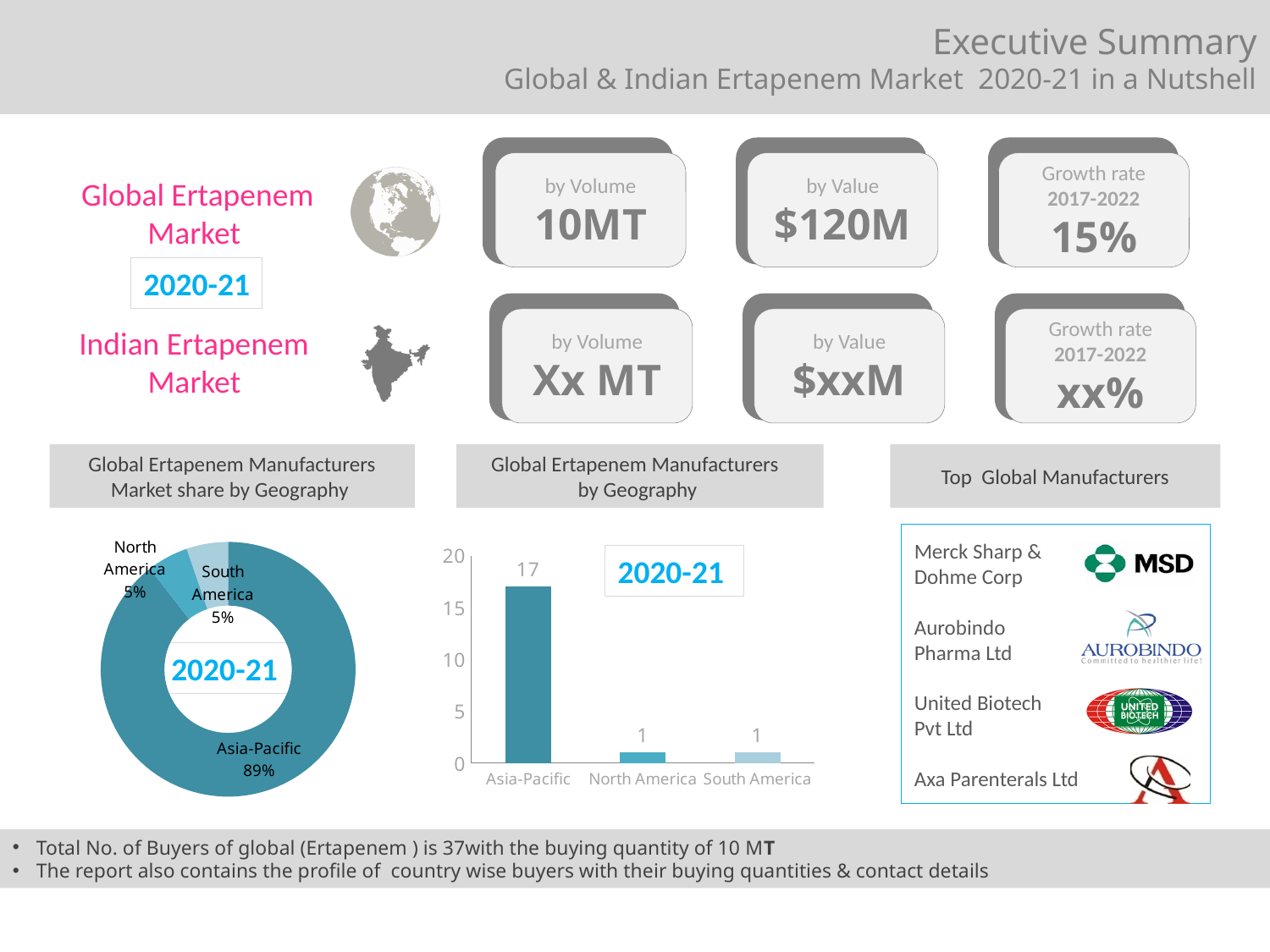
In the 'Global Ertapenem Manufacturers Market share by Geography' chart, what share does North America hold? 5% In the 'Global Ertapenem Manufacturers by Geography' chart, is the value for Asia-Pacific greater or less than 15? greater In the 'Global Ertapenem Manufacturers by Geography' chart, what is the value for Asia-Pacific? 17 What year label is shown inside the 'Global Ertapenem Manufacturers Market share by Geography' chart? 2020-21 In the 'Global Ertapenem Manufacturers by Geography' chart, what is the value for South America? 1 In the 'Global Ertapenem Manufacturers by Geography' chart, what is the difference between the values for Asia-Pacific and North America? 16 How many regions are shown in the 'Global Ertapenem Manufacturers Market share by Geography' chart? 3 What kind of chart is the 'Global Ertapenem Manufacturers Market share by Geography' chart? Doughnut chart In the 'Global Ertapenem Manufacturers Market share by Geography' chart, which region has the largest share? Asia-Pacific In the 'Global Ertapenem Manufacturers by Geography' chart, which region has the highest value? Asia-Pacific In the 'Global Ertapenem Manufacturers Market share by Geography' chart, what share does Asia-Pacific hold? 89% What kind of chart is the 'Global Ertapenem Manufacturers by Geography' chart? Bar chart